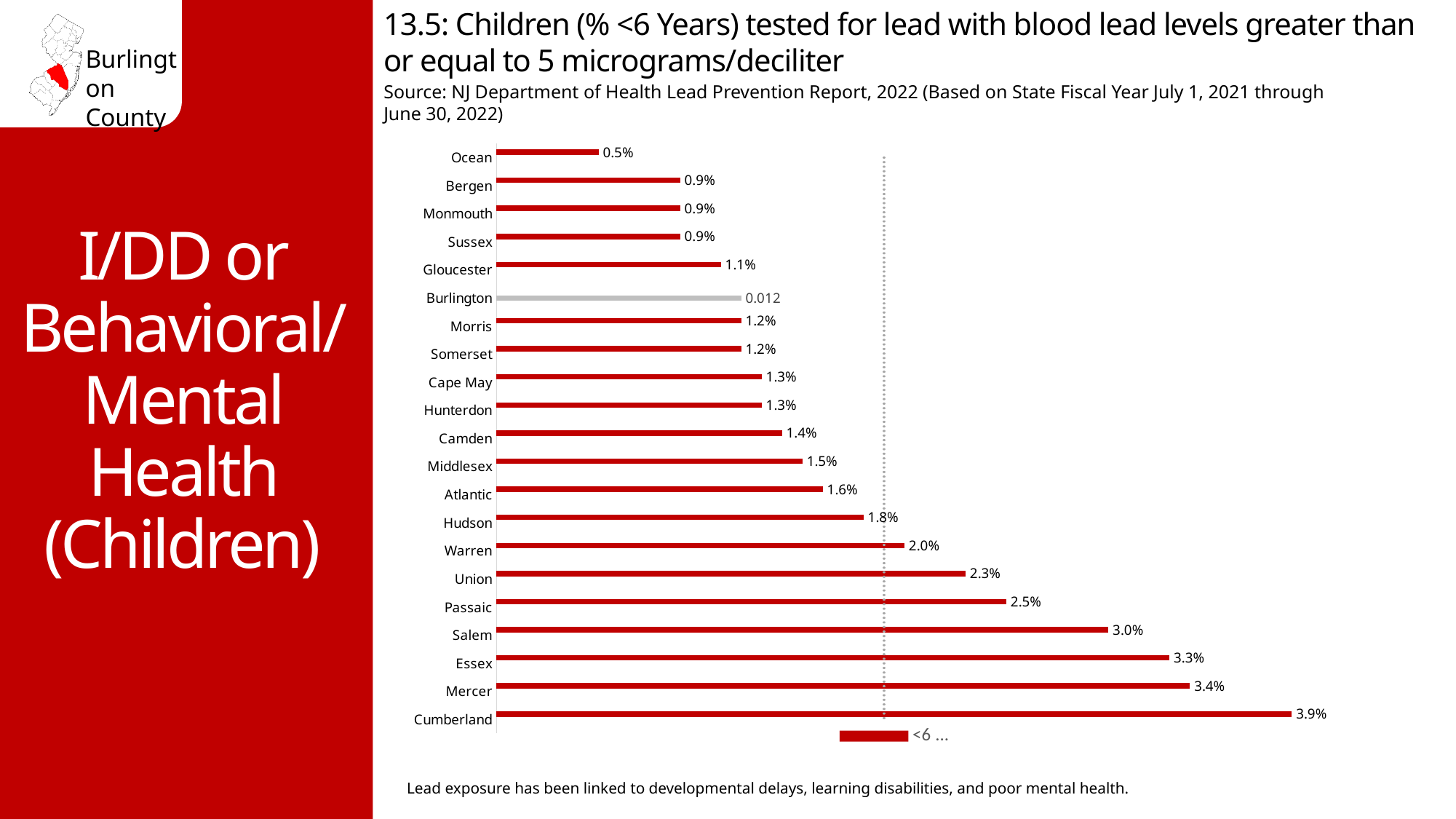
What is the difference between the values for Mercer and Essex? 0.1% What is the value for Warren? 2.0% What is the value for Hudson? 1.8% Which county has the lowest value? Ocean Which county's bar is shown in gray rather than red? Burlington What is the difference between the values for Cumberland and Ocean? 3.4% Which county has the highest value? Cumberland What is the value shown for Burlington? 0.012 What is the value for Cumberland? 3.9% Which has a larger value, Salem or Passaic? Salem How many counties are shown in the chart? 21 What kind of chart is shown on the slide? Bar chart